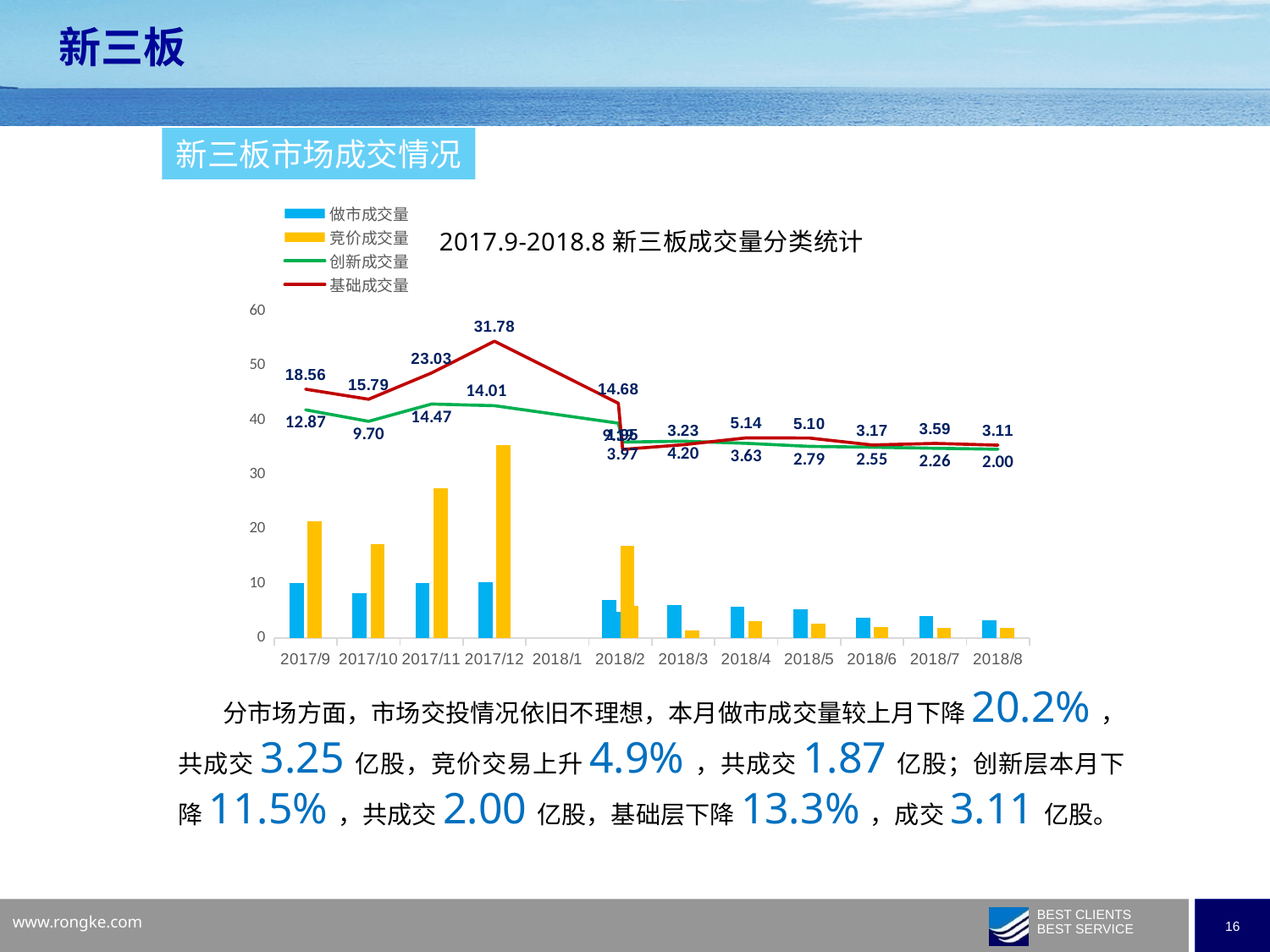
Is the 做市成交量 bar for 2017/9 greater or less than 20? less What is the value of 基础成交量 for 2018/4? 5.14 How many months are shown on the x axis? 12 What is the difference between 基础成交量 in 2017/12 and in 2017/11? 8.75 What kind of chart is shown? Combined bar and line chart What is the value of 基础成交量 for 2017/12? 31.78 In which month is 创新成交量 lowest? 2018/8 Is the 竞价成交量 bar for 2017/12 greater or less than 30? greater In 2017/9, which is larger: 基础成交量 or 创新成交量? 基础成交量 How many series does the legend list? 4 What is the value of 创新成交量 for 2018/8? 2.00 In which month is 基础成交量 highest? 2017/12